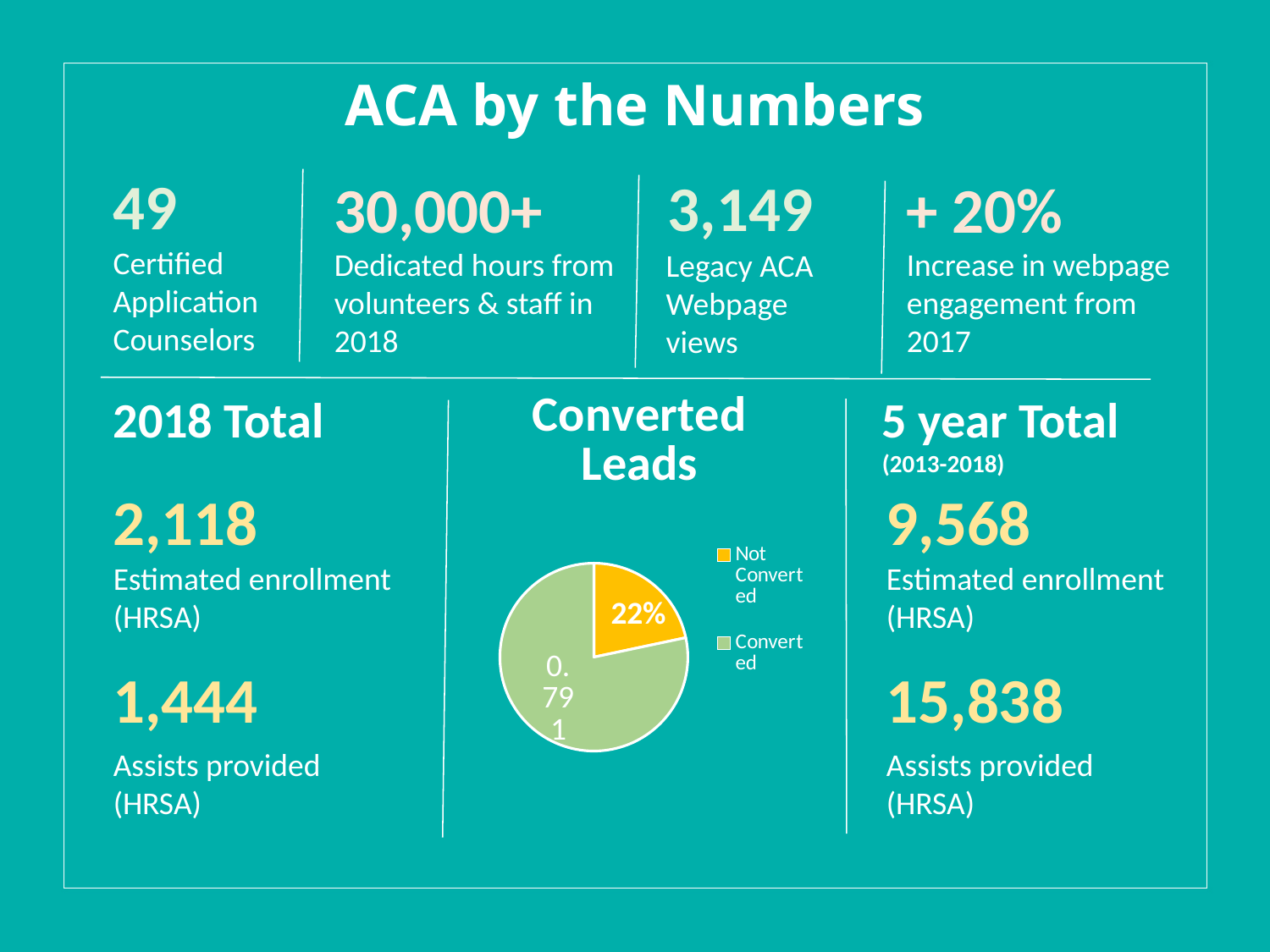
How many entries does the legend of the Converted Leads chart list? 2 In the Converted Leads chart, what is the data label on the Converted slice? 0.791 What is the title of the pie chart on the slide? Converted Leads In the Converted Leads chart, what is the data label on the Not Converted slice? 22% How many slices does the Converted Leads pie chart have? 2 What share of the Converted Leads pie is Not Converted? 22% What kind of chart is the Converted Leads chart? pie chart In the Converted Leads chart, which is larger: the Converted slice or the Not Converted slice? Converted What colour is the Not Converted slice in the Converted Leads chart? yellow Which slice is the smallest in the Converted Leads pie chart? Not Converted Which slice is the largest in the Converted Leads pie chart? Converted